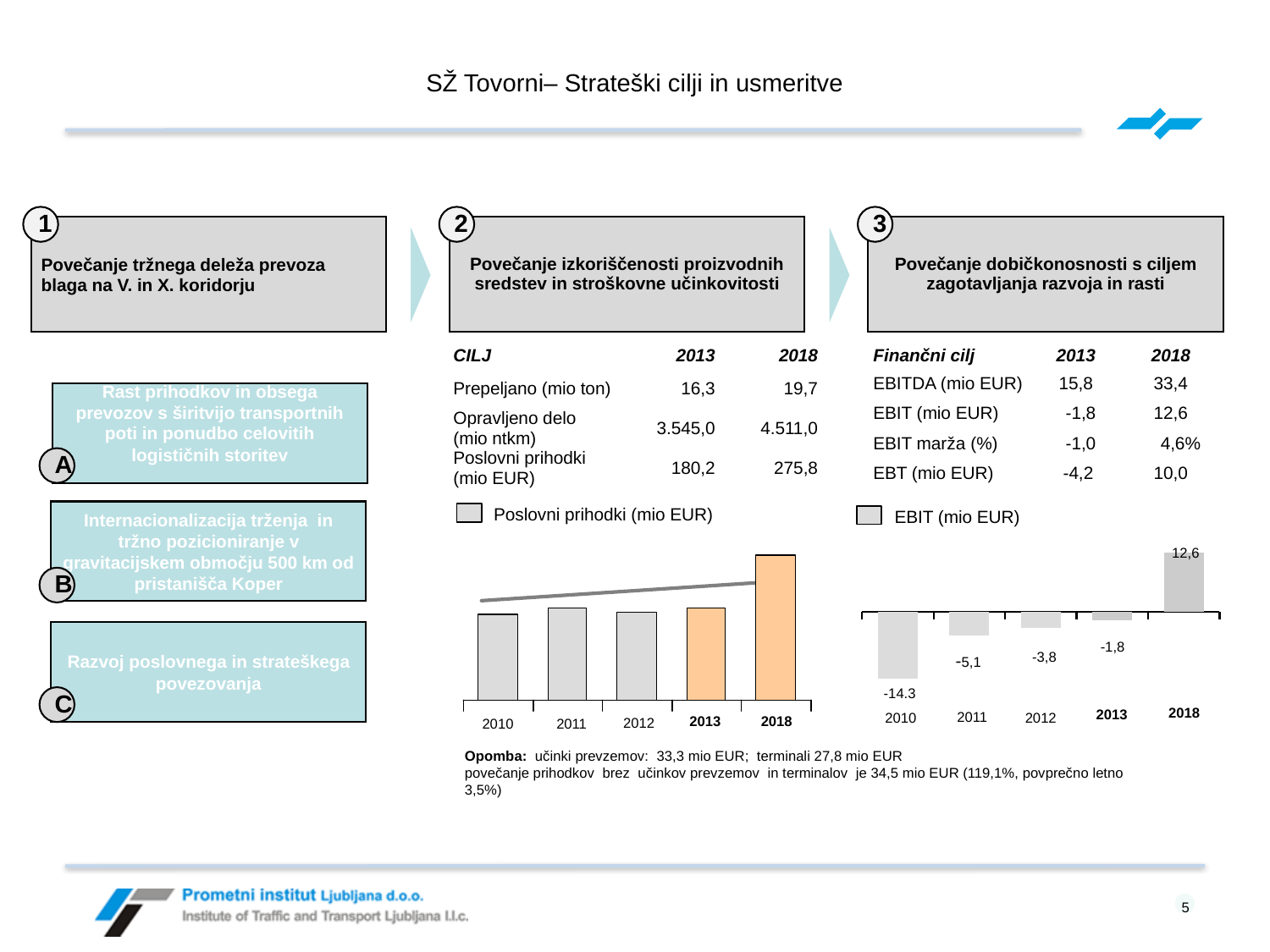
In the EBIT (mio EUR) chart, what is the value for 2010? -14.3 What kind of chart is the Poslovni prihodki (mio EUR) chart? bar chart In the EBIT (mio EUR) chart, do the values rise or fall from 2010 to 2018? rise In the EBIT (mio EUR) chart, what is the value for 2011? -5,1 In the EBIT (mio EUR) chart, which year has the highest value? 2018 In the EBIT (mio EUR) chart, is the value for 2011 larger or smaller than the value for 2012? smaller In the Poslovni prihodki (mio EUR) chart, is the bar for 2018 larger or smaller than the bar for 2010? larger In the EBIT (mio EUR) chart, what is the difference between the 2012 value and the 2013 value? 2,0 In the EBIT (mio EUR) chart, what is the value for 2018? 12,6 In the EBIT (mio EUR) chart, which year has the lowest value? 2010 In the Poslovni prihodki (mio EUR) chart, which year has the highest bar? 2018 How many years are shown in the EBIT (mio EUR) chart? 5